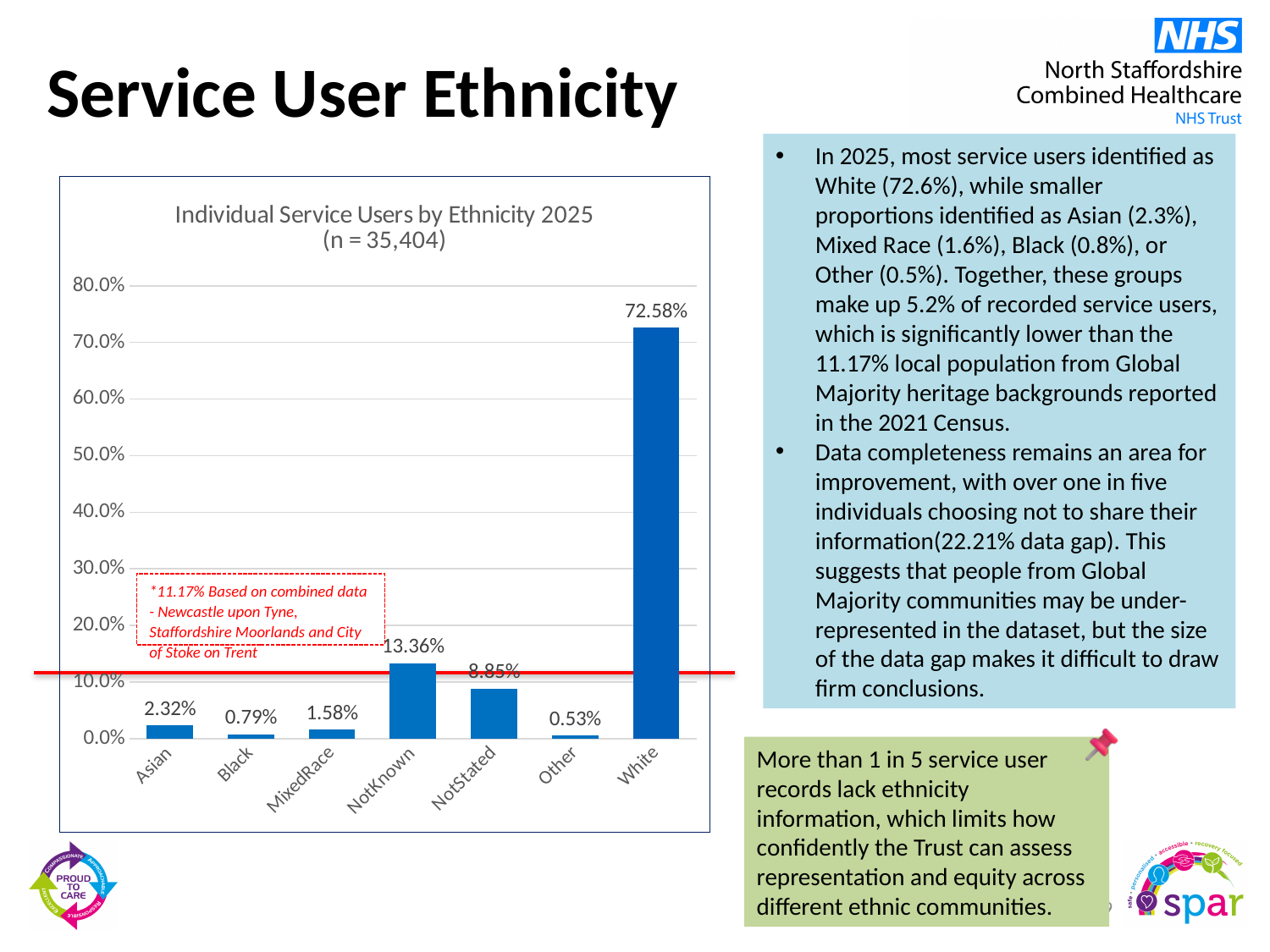
What is the value for NotKnown in the chart? 13.36% Is the value for White greater or less than 70.0%? greater What sample size (n) is given in the chart title? 35,404 What is the difference between the values for NotKnown and NotStated? 4.51% What is the value for NotStated in the chart? 8.85% What is the value for White in the Individual Service Users by Ethnicity 2025 chart? 72.58% What kind of chart is shown on the slide? Bar chart How many ethnicity categories are shown on the x axis of the chart? 7 Which category has the lowest value in the chart? Other What is the value for Asian in the chart? 2.32% Which is larger, the value for Asian or the value for MixedRace? Asian Which category has the highest value in the chart? White